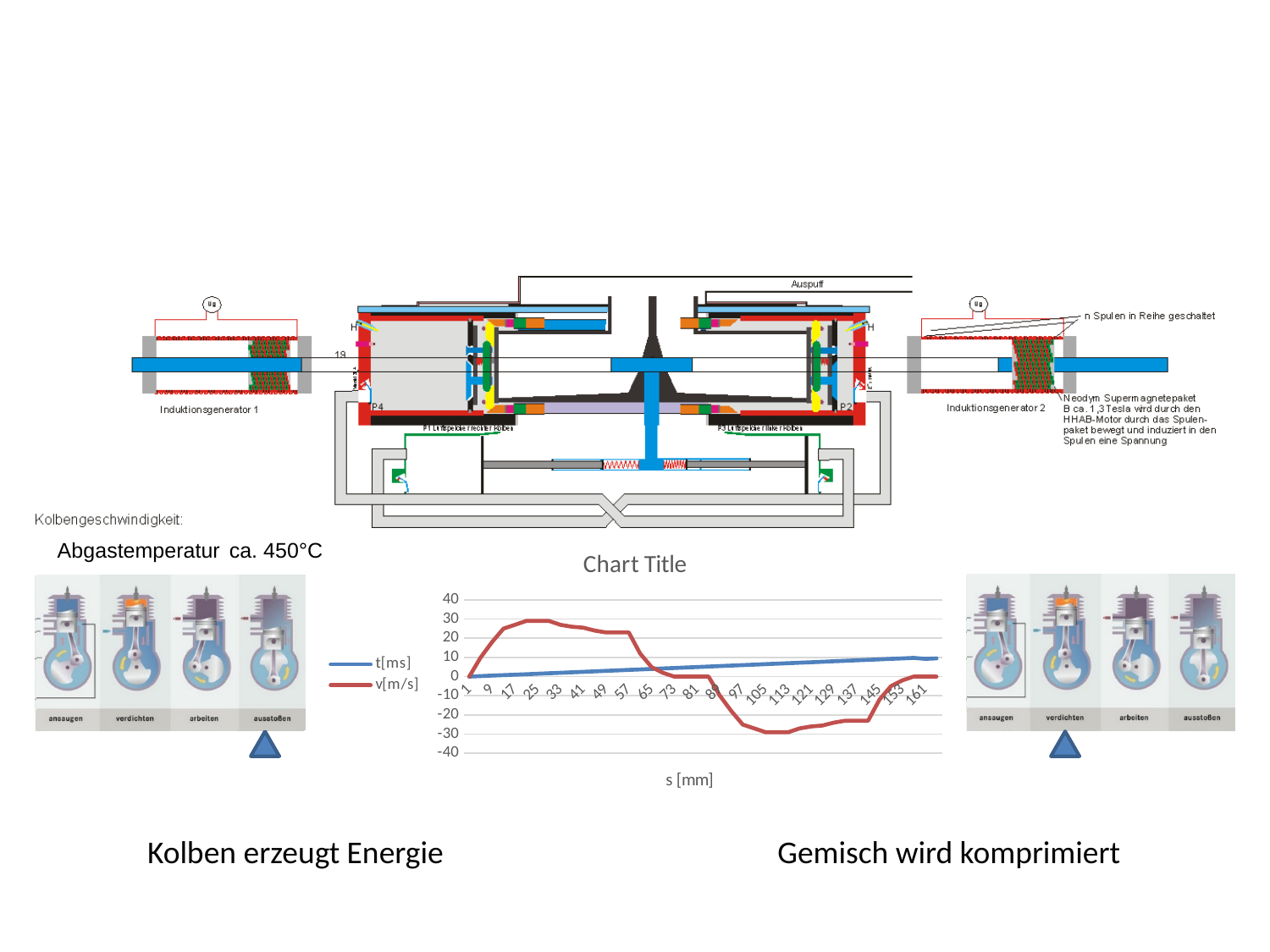
How many series does the chart's legend list? 2 Is the value of v[m/s] at s = 17 greater or less than 20? greater Does the t[ms] series rise or fall as s increases along the x axis? rises How many tick labels are shown on the chart's x axis? 21 What is the title of the chart? Chart Title Is the value of v[m/s] at s = 113 greater or less than -20? less Is the highest value of the v[m/s] series greater or less than 20? greater What is the label of the chart's x axis? s [mm] At s = 113, which series has the larger value, t[ms] or v[m/s]? t[ms] What kind of chart is shown on the slide? line chart At s = 17, which series has the larger value, t[ms] or v[m/s]? v[m/s]